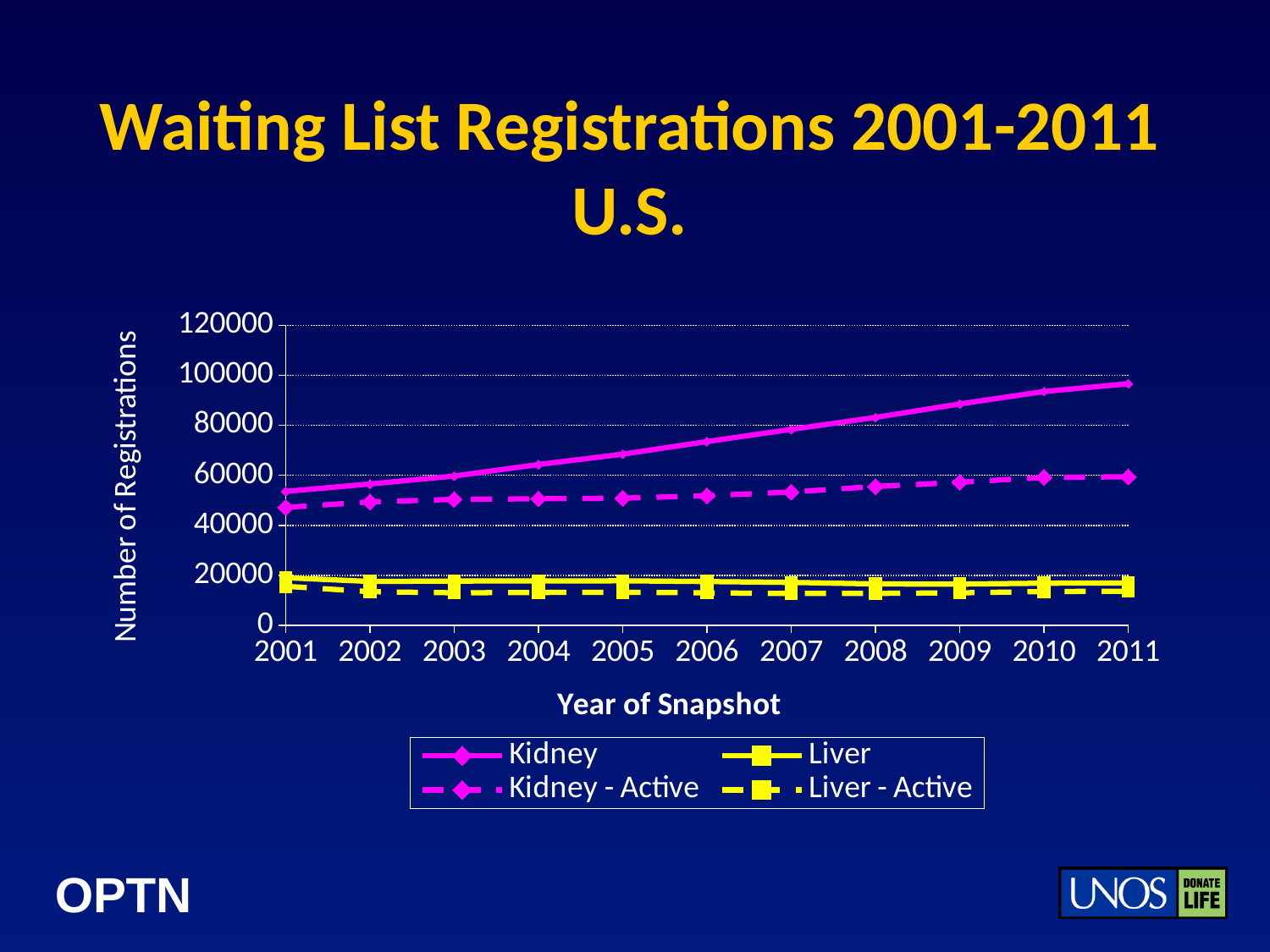
Does the Kidney series rise or fall from 2001 to 2011? rise What is the label of the y axis? Number of Registrations Is the Kidney value in 2001 greater or less than 60000? less Is the Kidney - Active value in 2011 greater or less than 40000? greater What kind of chart is shown on the slide? line chart Which is larger in 2008, the Kidney value or the Kidney - Active value? Kidney Which series has the lowest value in 2011? Liver - Active Which series has the highest value in 2011? Kidney How many series does the legend list? 4 Is the Kidney value in 2011 greater or less than 80000? greater How many years are shown along the x axis? 11